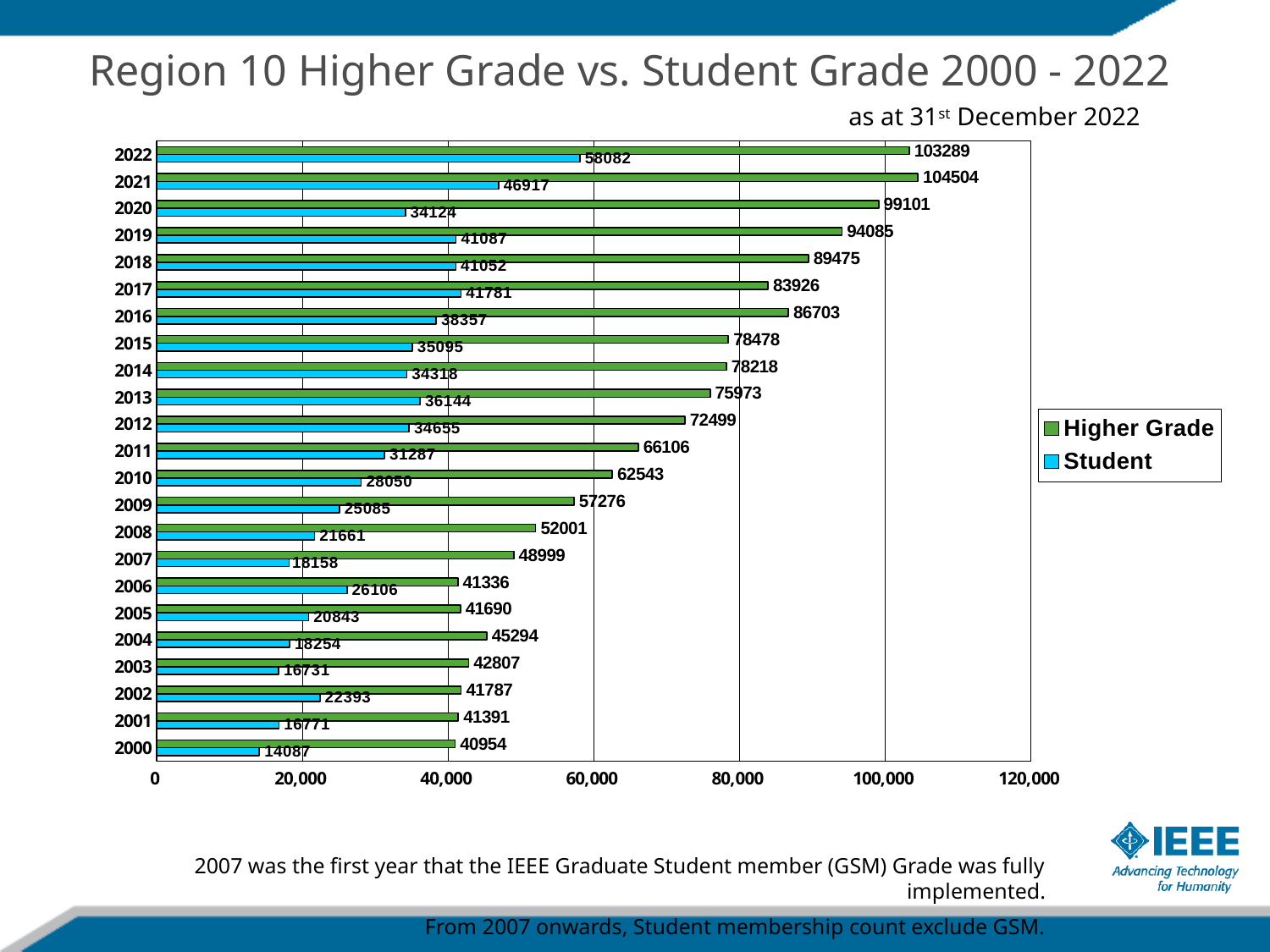
What kind of chart is shown on the slide? bar chart Which colour represents the Student series? blue What is the difference between the Higher Grade and Student values for 2022? 45207 How many years are shown on the chart? 23 What is the Higher Grade value for 2007? 48999 Which is larger, the Student value for 2006 or the Student value for 2005? 2006 Is the Higher Grade value for 2020 greater or less than 80,000? greater How many series does the legend list? 2 Which year has the lowest Student value? 2000 What is the Student value for 2010? 28050 Which year has the highest Higher Grade value? 2021 What is the Higher Grade value for 2022? 103289